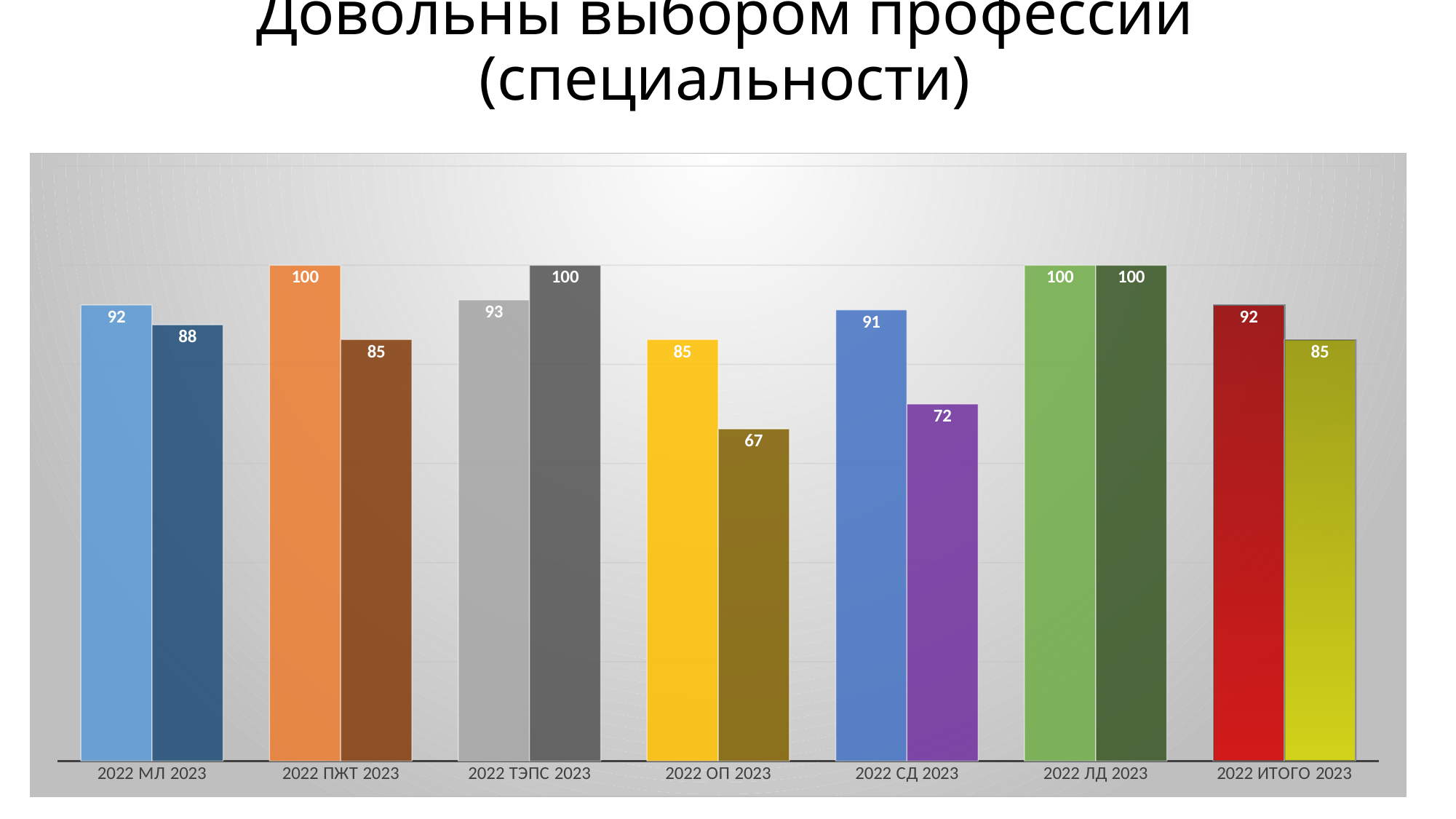
What is the 2023 value for МЛ? 88 What is the 2022 value for СД? 91 What is the 2022 value for ПЖТ? 100 What is the title of the chart? Довольны выбором профессии (специальности) What is the difference between the 2022 and 2023 values for СД? 19 Which is larger for ТЭПС, the 2022 value or the 2023 value? 2023 How many categories are shown on the x axis? 7 What kind of chart is shown on the slide? Bar chart What is the difference between the 2022 and 2023 values for ПЖТ? 15 What is the 2023 value for ИТОГО? 85 What is the 2023 value for ОП? 67 Which category has the lowest 2023 value? ОП